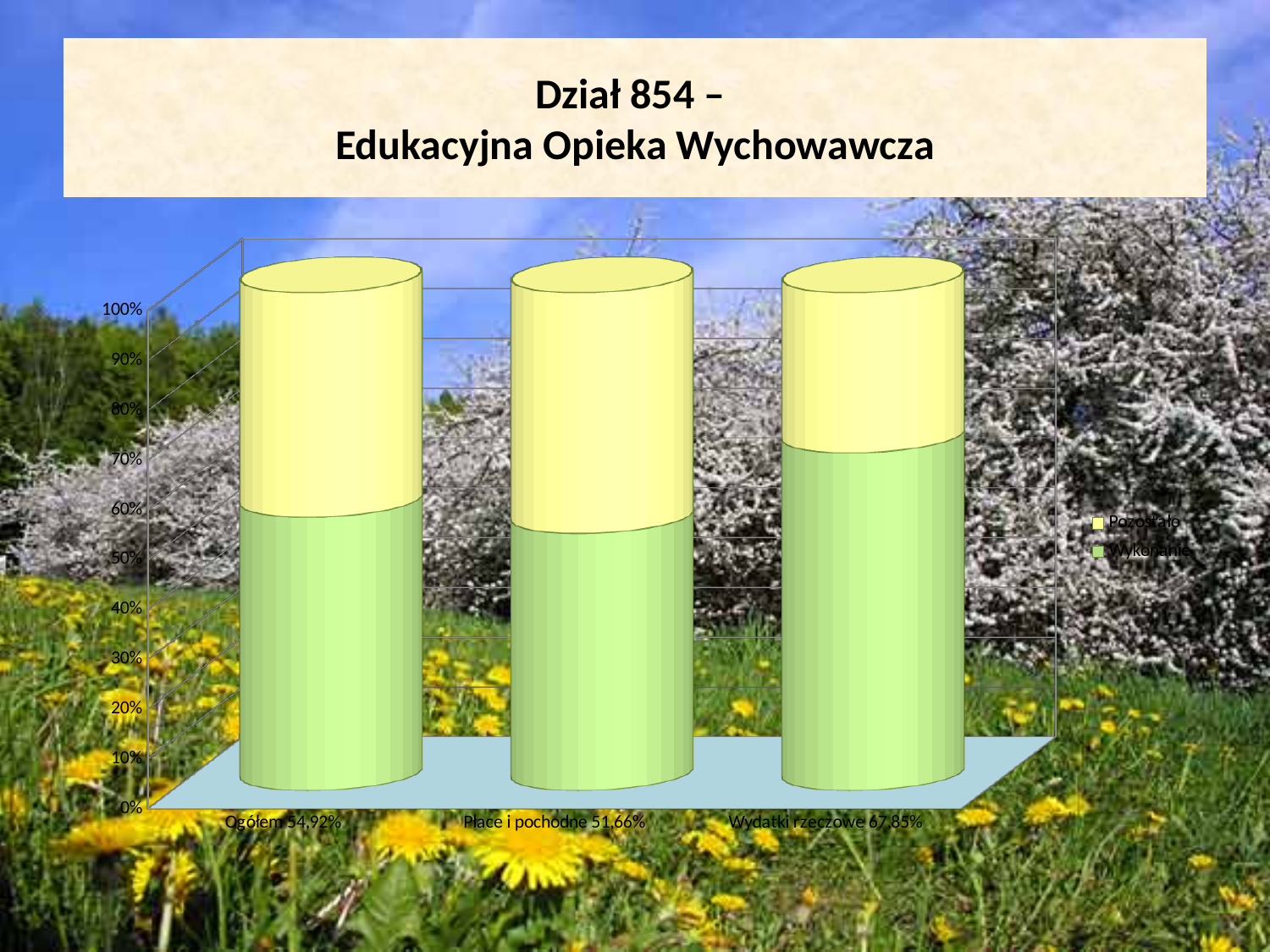
Which category has the lowest Wykonanie value? Płace i pochodne What kind of chart is shown on the slide? bar chart What percentage is printed in the category label for Ogółem? 54,92% What percentage is printed in the category label for Wydatki rzeczowe? 67,85% What percentage is printed in the category label for Płace i pochodne? 51,66% Which category has the highest Wykonanie value? Wydatki rzeczowe How many series does the chart legend list? 2 Which legend entry is shown in yellow? Pozostało What is the total height of the stacked bar for Ogółem? 100% Is the Wykonanie value for Wydatki rzeczowe greater or less than 60%? greater What is the difference between the percentages printed for Wydatki rzeczowe and Płace i pochodne? 16,19% How many categories are shown on the x axis of the chart? 3